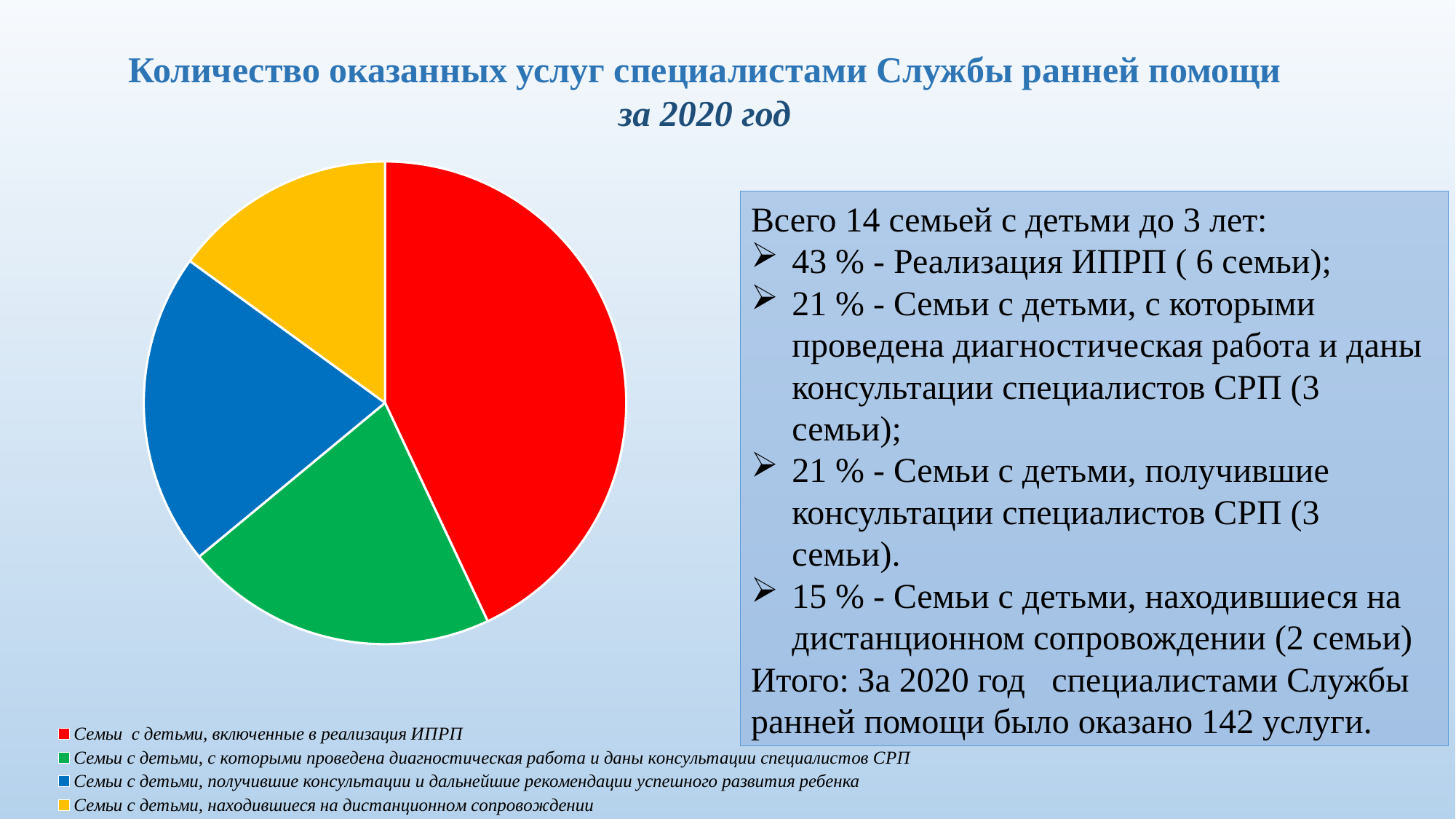
According to the slide, how many families in total are represented in the pie chart? 14 What is the title of the slide containing the pie chart? Количество оказанных услуг специалистами Службы ранней помощи за 2020 год How many slices does the pie chart have? 4 Which slice is larger: the red slice (Семьи с детьми, включенные в реализация ИПРП) or the green slice (Семьи с детьми, с которыми проведена диагностическая работа и даны консультации специалистов СРП)? the red slice (Семьи с детьми, включенные в реализация ИПРП) Which slice is larger: the blue slice (Семьи с детьми, получившие консультации и дальнейшие рекомендации успешного развития ребенка) or the yellow slice (Семьи с детьми, находившиеся на дистанционном сопровождении)? the blue slice According to the slide, what share of the pie does the slice for families on remote support (дистанционное сопровождение, yellow) represent? 15 % What colour is the largest slice of the pie chart? red Which category has the smallest slice of the pie chart? Семьи с детьми, находившиеся на дистанционном сопровождении How many entries does the legend of the pie chart list? 4 What kind of chart is shown on the slide? pie chart Which category has the largest slice of the pie chart? Семьи с детьми, включенные в реализация ИПРП According to the slide, what share of the pie does the slice for Реализация ИПРП (red) represent? 43 %